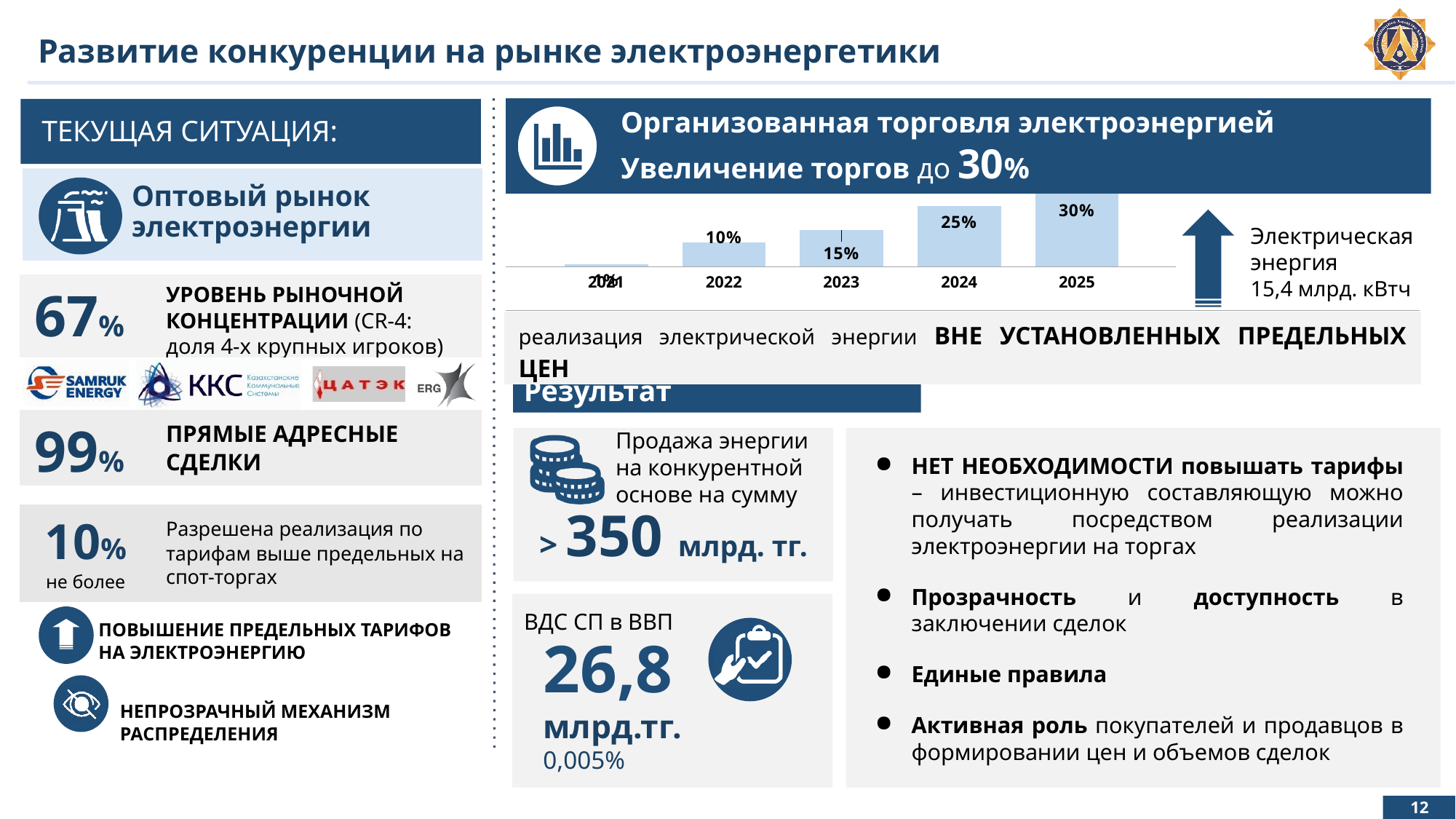
What is the value shown for 2022 in the bar chart? 10% What is the value shown for 2024 in the bar chart? 25% What is the value shown for 2025 in the bar chart? 30% What type of chart is shown under the heading 'Организованная торговля электроэнергией'? bar chart Which year has the lowest value in the bar chart? 2021 Which is larger in the bar chart, the value for 2023 or the value for 2024? 2024 Do the values in the bar chart rise or fall from 2021 to 2025? rise How many years are shown on the x axis of the bar chart? 5 What is the difference between the values for 2025 and 2024 in the bar chart? 5% Which year has the highest value in the bar chart? 2025 What is the difference between the values for 2024 and 2022 in the bar chart? 15% What is the value shown for 2023 in the bar chart? 15%